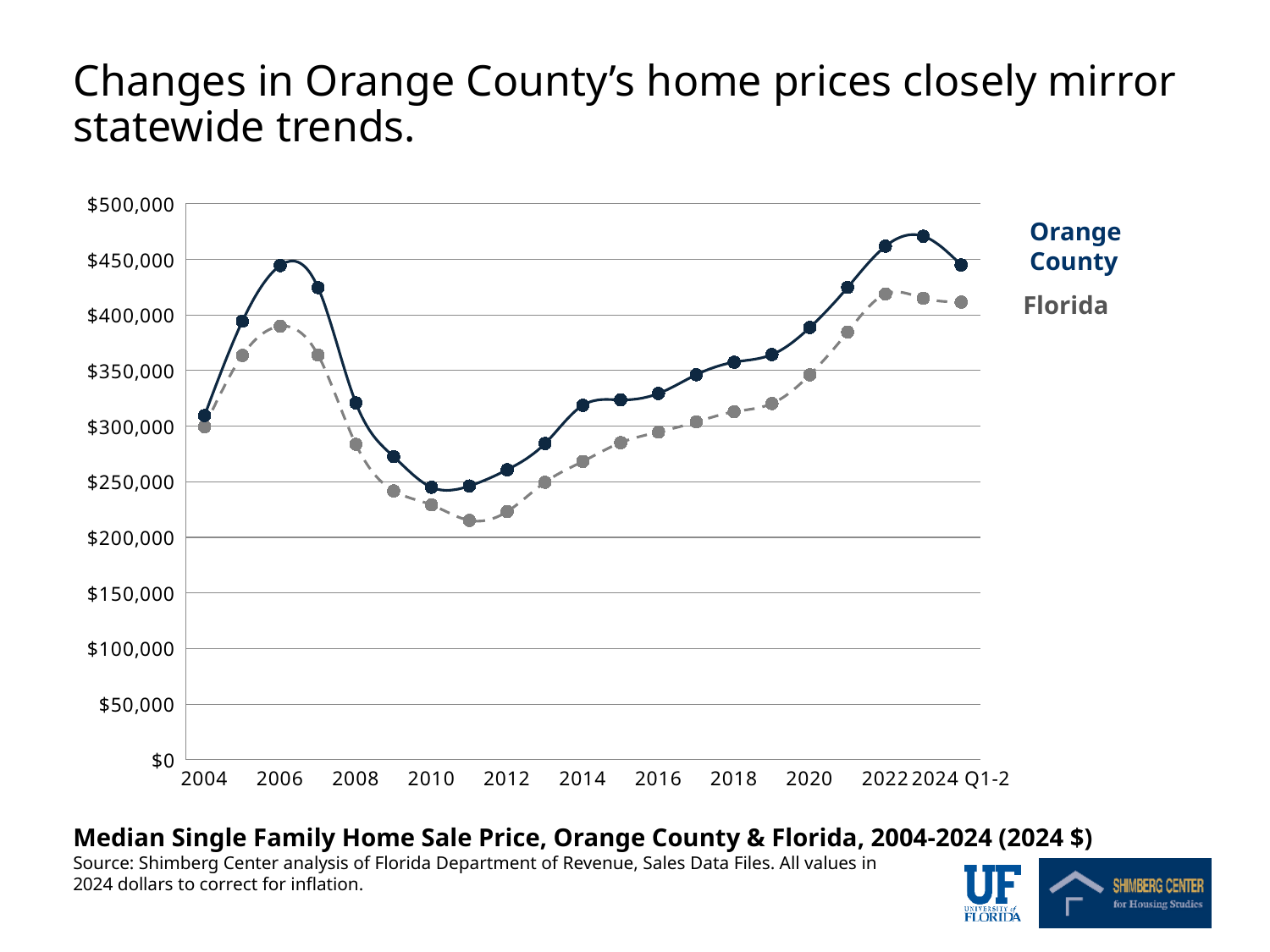
How many series does the chart's legend list? 2 Is the Orange County value for 2006 greater or less than $400,000? greater What kind of chart is shown on the slide? Line chart In which year does the Orange County series reach its highest value? 2023 In which year does the Florida series reach its lowest value? 2011 Which two series are plotted on the chart? Orange County and Florida Is the Florida value for 2011 greater or less than $250,000? less Do the Orange County values rise or fall between 2006 and 2010? Fall In 2006, which series has the higher value, Orange County or Florida? Orange County Is the Orange County value for 2023 greater or less than $450,000? greater How many data points are plotted for the Orange County series? 21 What is the title of the chart? Median Single Family Home Sale Price, Orange County & Florida, 2004-2024 (2024 $)